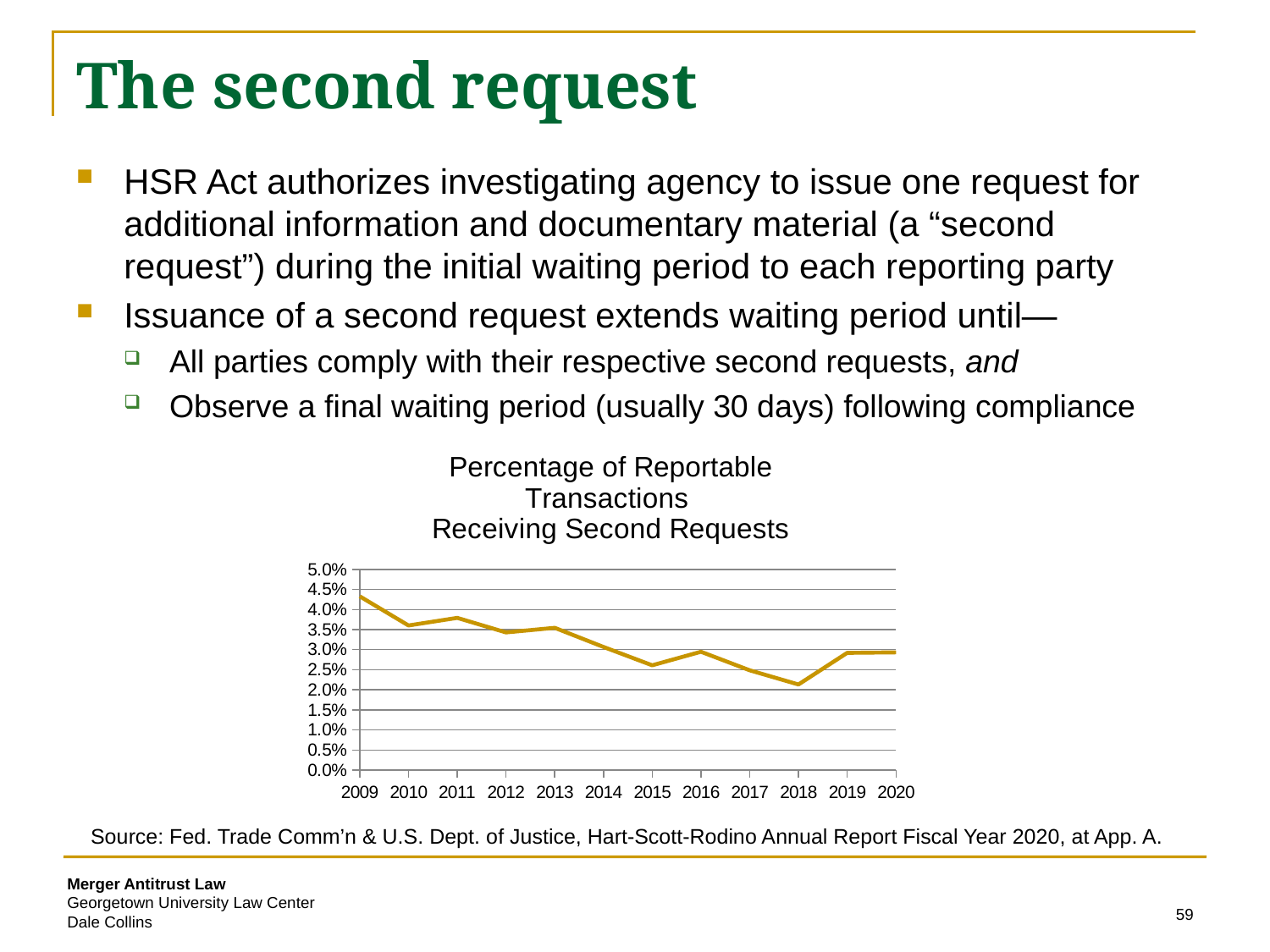
Is the value for 2015 greater or less than 3.0%? less Is the value for 2009 greater or less than 4.0%? greater Overall, does the percentage of reportable transactions receiving second requests rise or fall from 2009 to 2020? fall What kind of chart is shown on the slide? line chart Is the value for 2011 greater or less than 4.0%? less How many years are plotted on the x axis of the chart? 12 Which year has the lowest percentage of reportable transactions receiving second requests? 2018 Which year has a higher value, 2011 or 2015? 2011 Which year has the highest percentage of reportable transactions receiving second requests? 2009 What is the title of the chart? Percentage of Reportable Transactions Receiving Second Requests